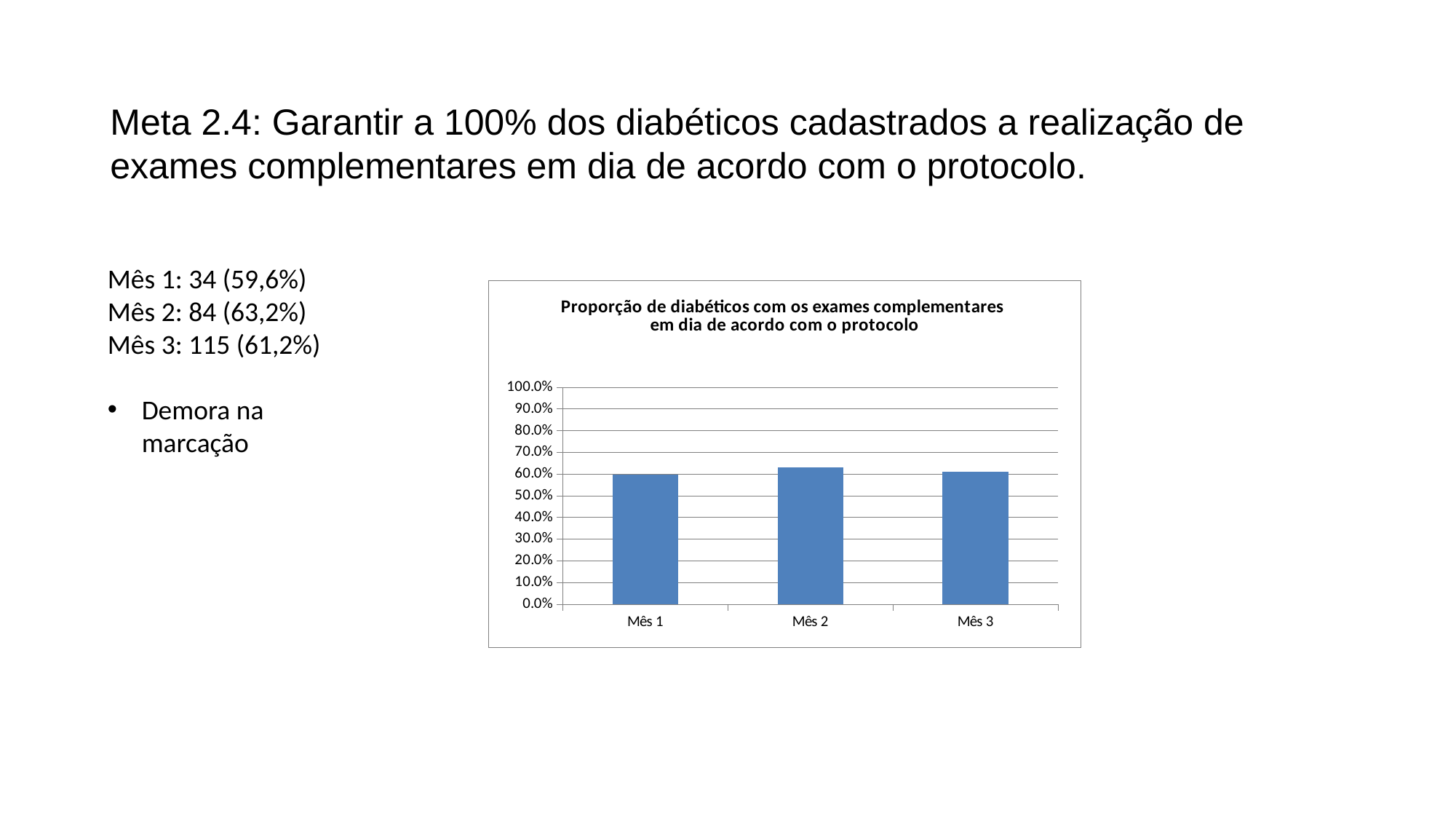
Which month has the highest bar in the chart? Mês 2 What kind of chart is shown on the slide? bar chart Is the value for Mês 3 greater or less than 70.0%? less What is the title of the chart? Proporção de diabéticos com os exames complementares em dia de acordo com o protocolo Is the value for Mês 2 greater or less than 70.0%? less Is the value for Mês 1 greater or less than 50.0%? greater How many categories (months) are plotted in the chart? 3 Is the bar for Mês 2 higher or lower than the bar for Mês 1? higher What is the highest value shown on the chart's vertical axis? 100.0%